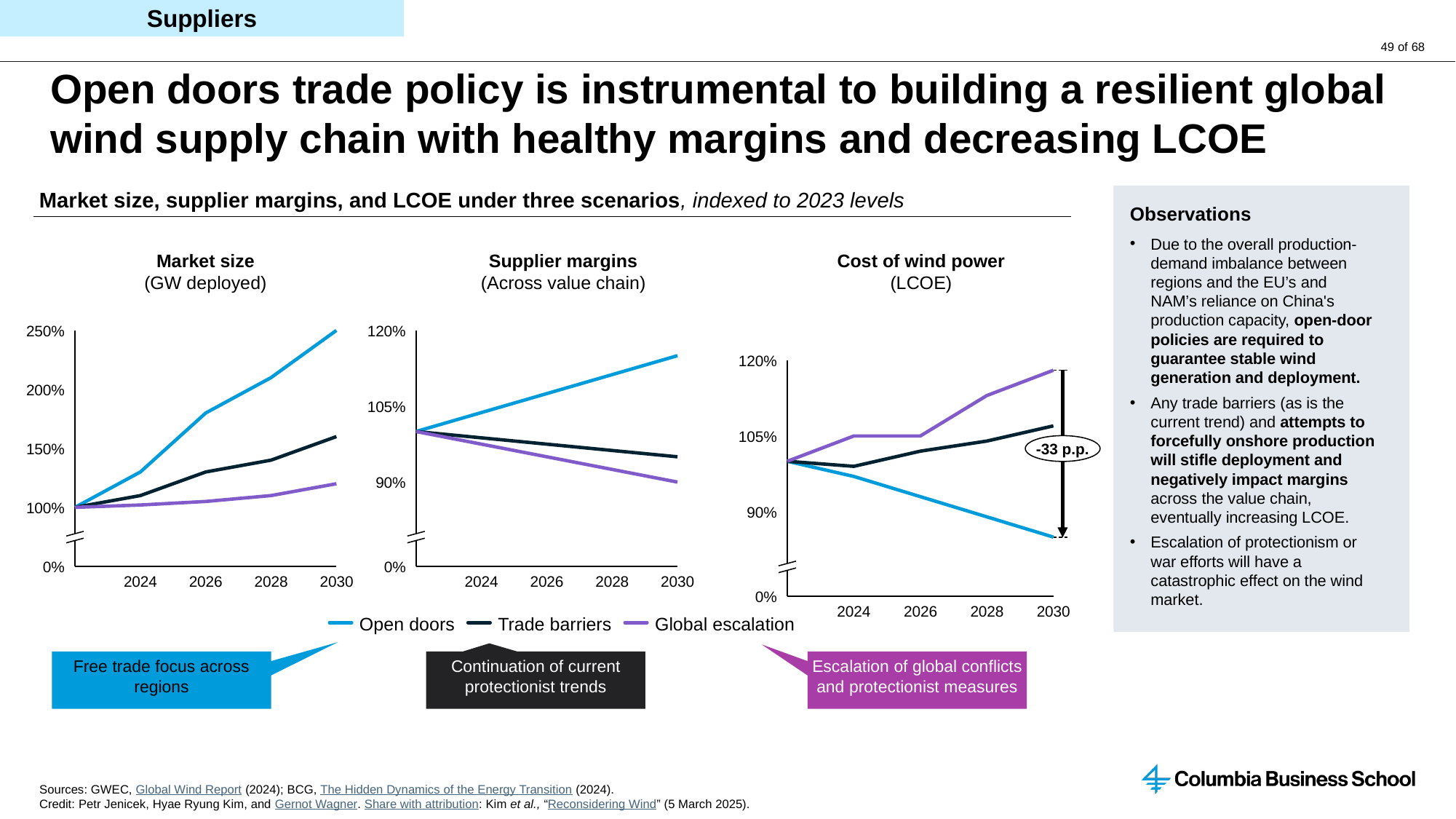
In the Cost of wind power chart, what difference is shown by the annotation between the Global escalation and Open doors lines in 2030? -33 p.p. In the Cost of wind power chart, is the 2030 value for Global escalation greater or less than 105%? greater How many series does the shared legend list? 3 In the Market size chart, is the 2030 value for Trade barriers greater or less than 150%? greater In the Market size chart, which scenario has the highest value in 2030? Open doors What colour is the Open doors series in the legend? blue In the Supplier margins chart, is the 2030 value for Open doors greater or less than 105%? greater What kind of chart is the Market size chart? line chart In the Market size chart, which is larger in 2030: Trade barriers or Global escalation? Trade barriers In the Supplier margins chart, do the values for Global escalation rise or fall over time? fall In the Cost of wind power chart, which scenario has the lowest value in 2030? Open doors